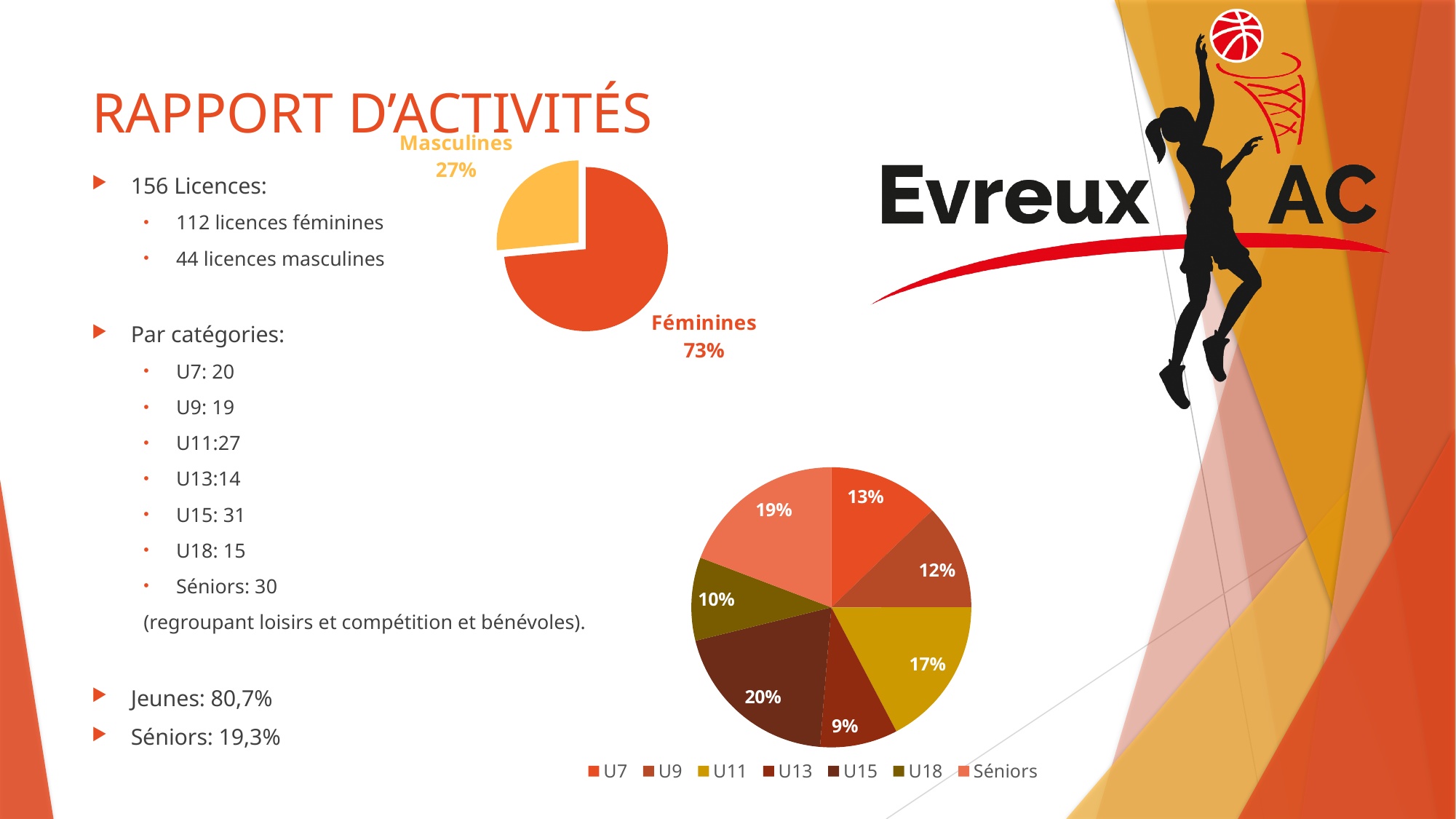
In the lower pie chart, what percentage is shown for U11? 17% In the upper pie chart, what share is labelled for Féminines? 73% What type of chart is the upper chart on the slide? Pie chart In the upper pie chart, what share is labelled for Masculines? 27% In the upper pie chart, what is the difference in percentage points between the Féminines and Masculines slices? 46 How many categories does the legend of the lower pie chart list? 7 In the lower pie chart, what percentage is shown for Séniors? 19% In the lower pie chart, which category has the smallest slice? U13 In the lower pie chart, what is the difference in percentage points between U7 and U9? 1 In the lower pie chart, which category has the largest slice? U15 In the upper pie chart, which slice is larger, Féminines or Masculines? Féminines In the lower pie chart, which category is shown in the legend immediately after U15? U18